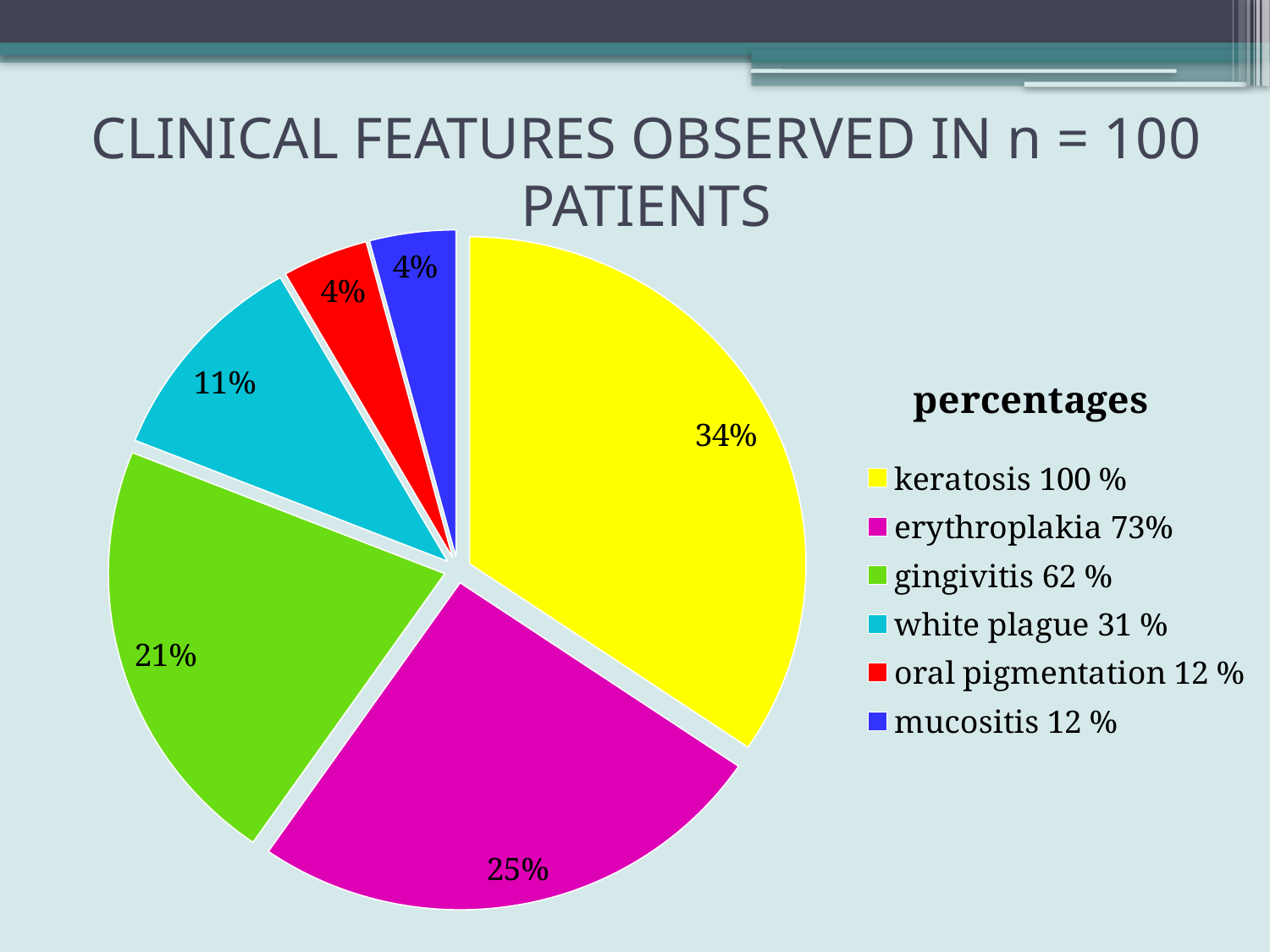
Which clinical feature has the largest slice of the pie? keratosis What share of the pie does the mucositis slice represent? 4% Which slice is larger, gingivitis or white plague? gingivitis What is the difference in percentage points between the keratosis slice (34%) and the erythroplakia slice (25%)? 9 What percentage label is shown on the gingivitis slice? 21% What type of chart is shown on the slide? pie chart How many slices does the pie chart have? 6 What percentage label is shown on the white plague slice? 11% What percentage label is shown on the erythroplakia slice? 25% What percentage label is shown on the keratosis slice? 34% What colour is the slice for oral pigmentation? red What is the title of the chart? percentages